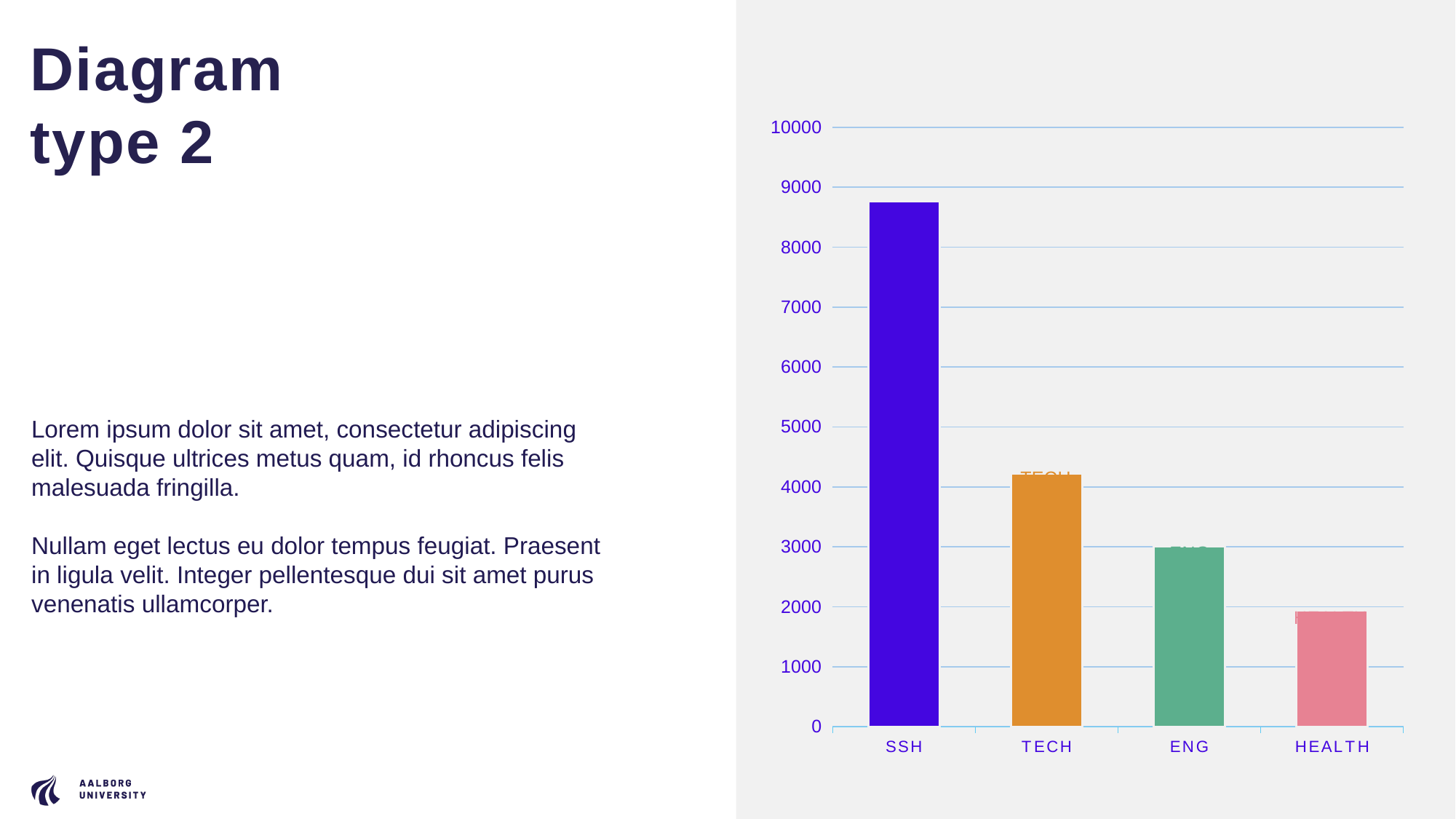
Do the bar values rise or fall from left to right along the x axis? fall What is the highest value shown on the chart's vertical axis? 10000 Which category has the highest bar in the chart? SSH What colour is the bar for SSH? purple What kind of chart is shown on the slide? bar chart How many categories are shown on the x axis of the chart? 4 Which is larger, the value for TECH or the value for ENG? TECH Which category has the lowest bar in the chart? HEALTH Is the value for TECH greater or less than 4000? greater Is the value for SSH greater or less than 8000? greater